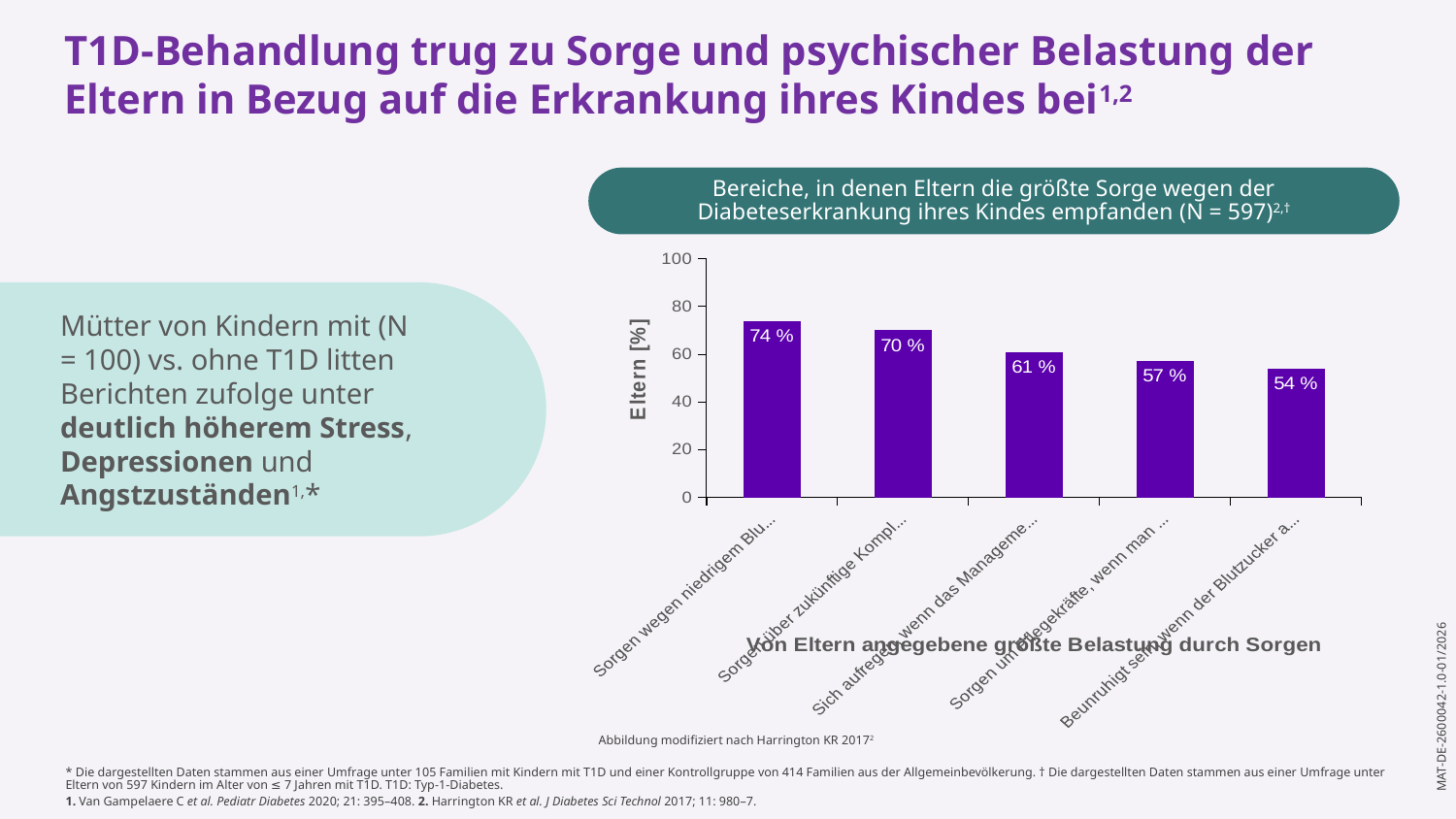
What is the value of the last bar, labelled "Beunruhigt sein, wenn der Blutzucker a..."? 54 % Which category has the lowest value in the chart? Beunruhigt sein, wenn der Blutzucker a... (54 %) What is the value of the bar labelled "Sorgen über zukünftige Kompl..."? 70 % What is the difference between the first bar (74 %) and the last bar (54 %)? 20 percentage points Which category has the highest value in the chart? Sorgen wegen niedrigem Blu... (74 %) What is the value of the middle (third) bar, labelled "Sich aufregen, wenn das Manageme..."? 61 % What is the value of the first bar, labelled "Sorgen wegen niedrigem Blu..."? 74 % Do the bar values rise or fall from left to right along the x axis? Fall What is the label of the y axis of the chart? Eltern [%] What type of chart is shown on the slide? Bar chart Which is larger: the value for "Sorgen um Pflegekräfte, wenn man ..." or the value for "Sich aufregen, wenn das Manageme..."? Sich aufregen, wenn das Manageme... (61 %) How many bars (categories) does the chart show? 5